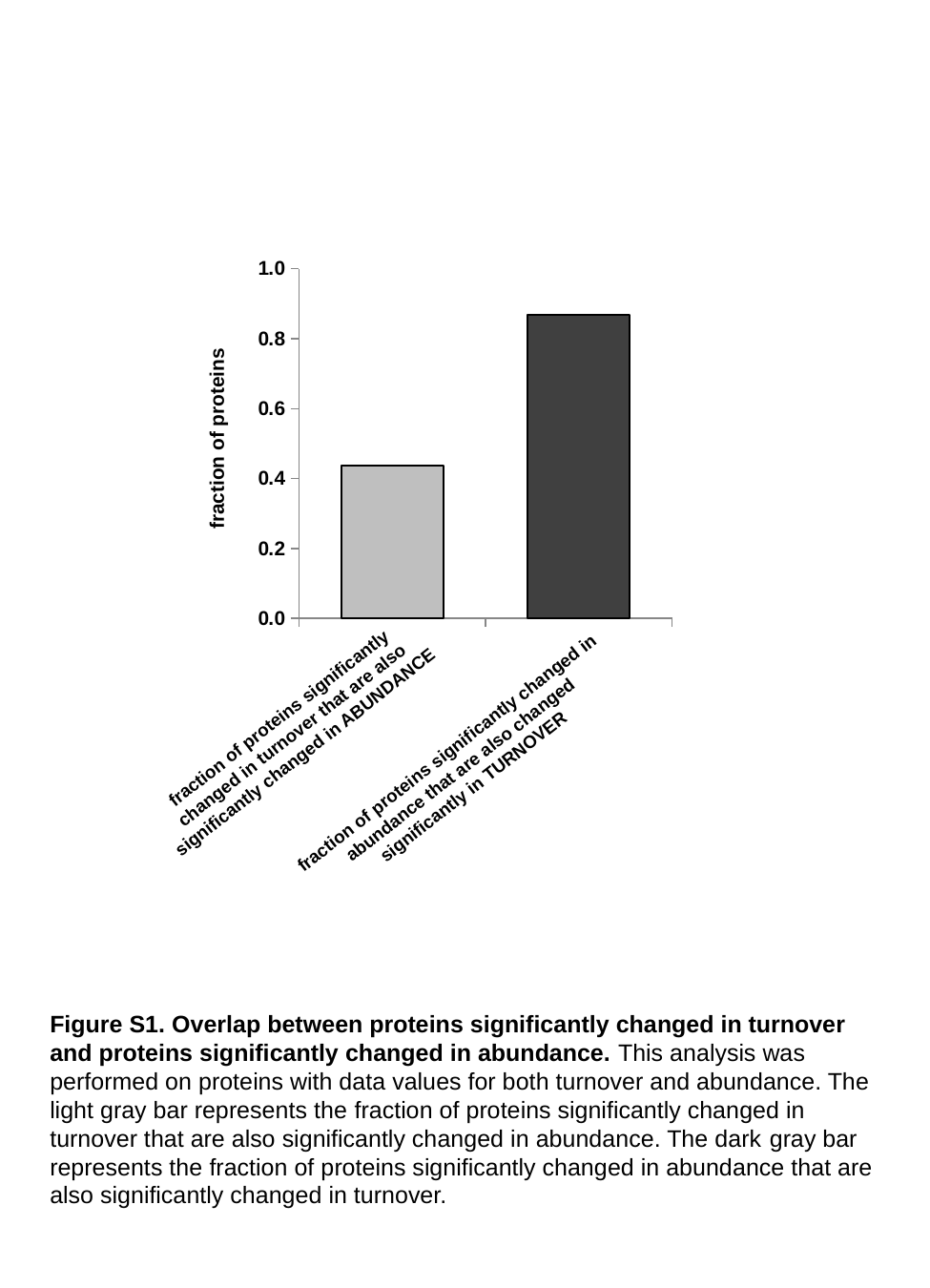
Which bar is taller: the light gray bar (fraction of proteins significantly changed in turnover that are also significantly changed in ABUNDANCE) or the dark gray bar (fraction of proteins significantly changed in abundance that are also significantly changed in TURNOVER)? the dark gray bar Which category has the lowest value in the chart? fraction of proteins significantly changed in turnover that are also significantly changed in ABUNDANCE How many bars are plotted in the chart? 2 Which category has the highest value in the chart? fraction of proteins significantly changed in abundance that are also significantly changed in TURNOVER Is the value for the fraction of proteins significantly changed in abundance that are also significantly changed in TURNOVER greater or less than 1.0? less What kind of chart is shown on the slide? bar chart What is the maximum value shown on the y axis of the chart? 1.0 Do the bar values rise or fall from left to right along the x axis? rise Is the value for the fraction of proteins significantly changed in abundance that are also significantly changed in TURNOVER greater or less than 0.8? greater Is the value for the fraction of proteins significantly changed in turnover that are also significantly changed in ABUNDANCE greater or less than 0.2? greater What is the label of the y axis of the chart? fraction of proteins